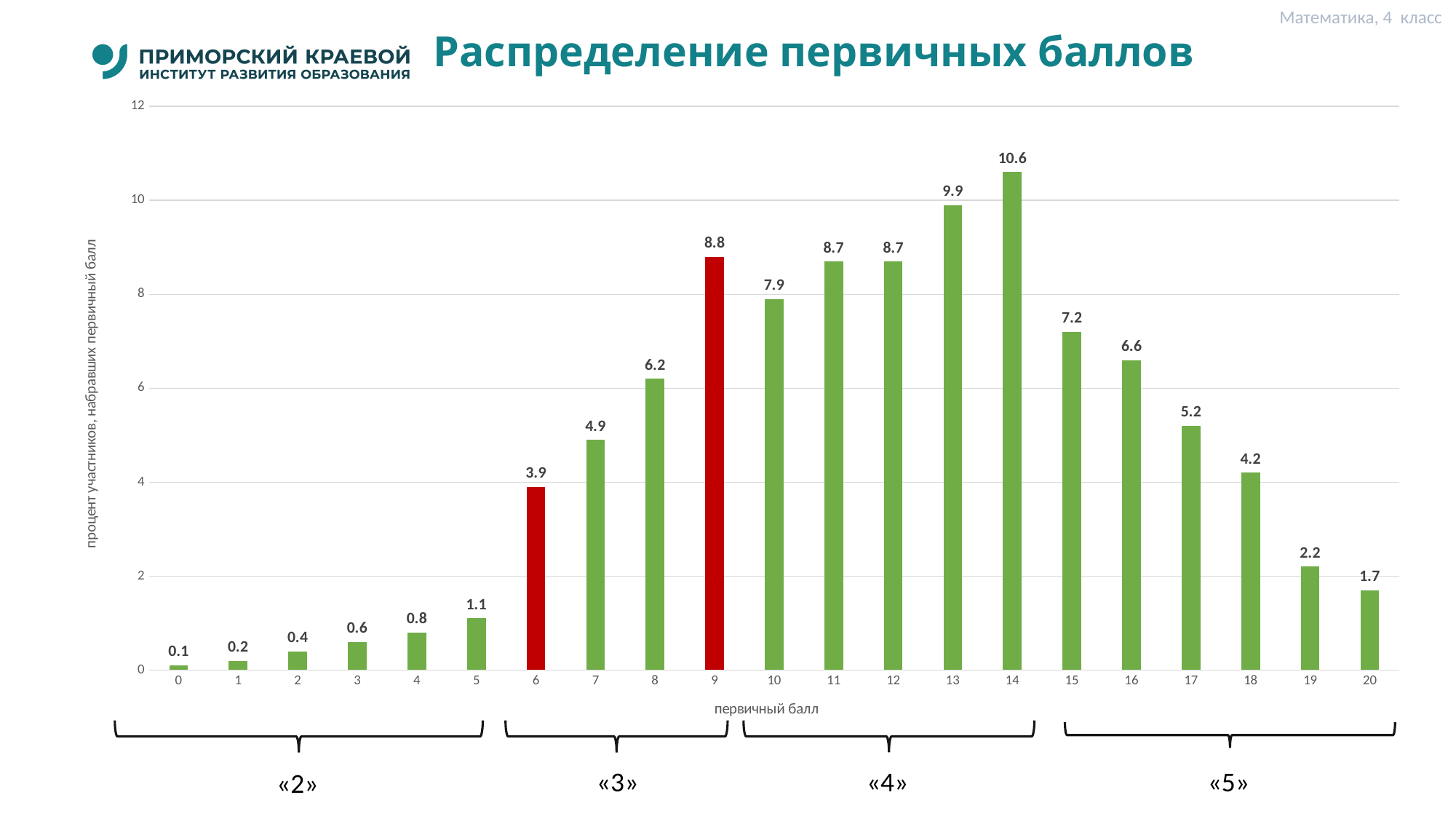
What percentage of participants scored a primary score of 14? 10.6 What is the value shown for primary score 0? 0.1 What kind of chart is shown on the slide? bar chart Which is larger, the value for primary score 9 or for primary score 10? primary score 9 How many primary score categories are shown on the x axis? 21 Is the value for primary score 15 greater or less than 6? greater Which primary score has the lowest percentage of participants? 0 Which two bars are coloured red instead of green? 6 and 9 What is the difference between the values for primary scores 14 and 13? 0.7 What is the value shown for primary score 9? 8.8 Which primary score has the highest percentage of participants? 14 Do the values rise or fall from primary score 14 to primary score 20? fall